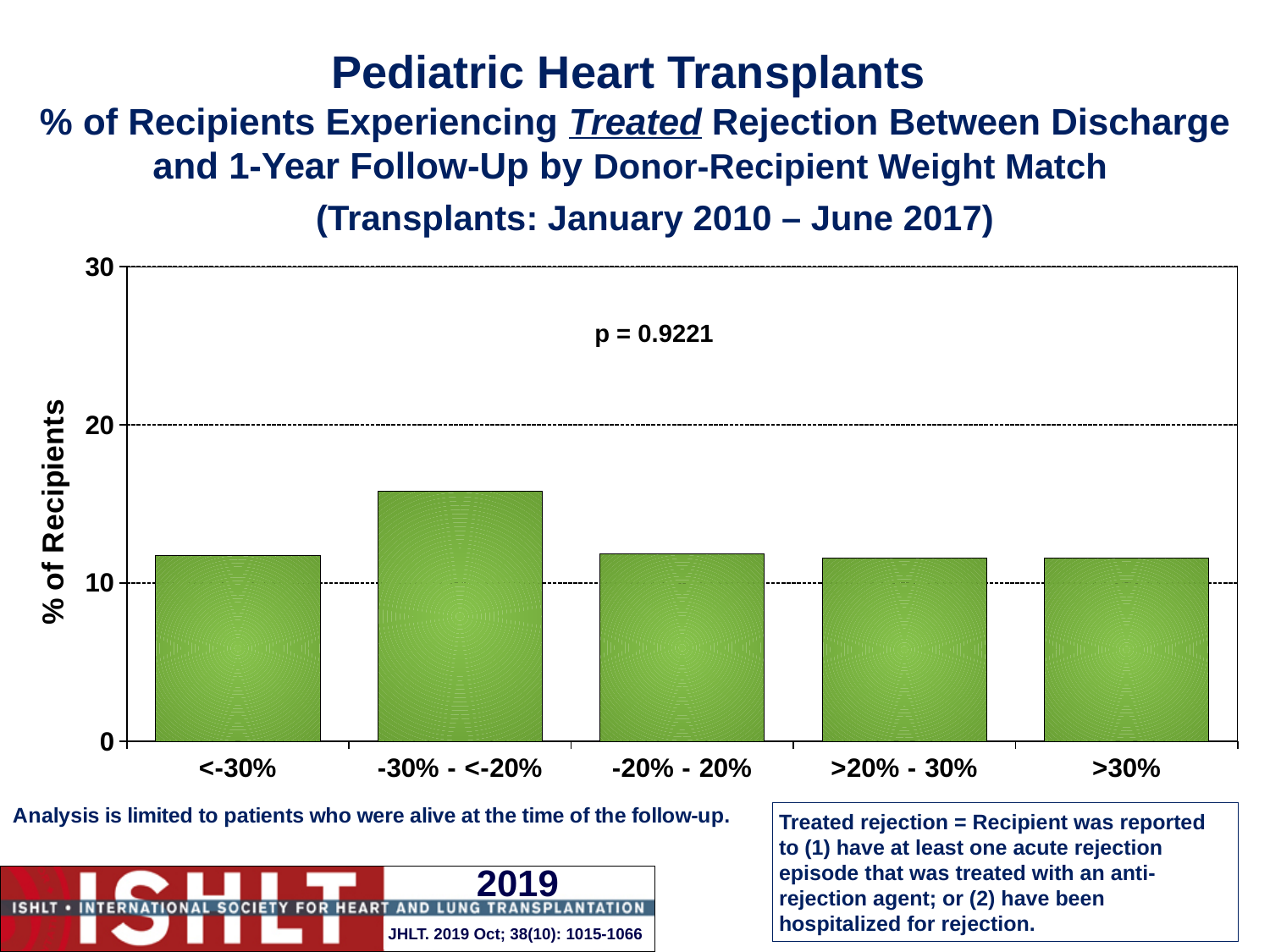
What is the maximum value shown on the y axis? 30 What kind of chart is shown on the slide? bar chart What p-value is printed on the chart? p = 0.9221 Which is larger, the value for -30% - <-20% or the value for >20% - 30%? -30% - <-20% Is the value for the >30% category greater or less than 20? less Which weight match category has the highest % of recipients experiencing treated rejection? -30% - <-20% How many donor-recipient weight match categories are shown on the x axis? 5 Is the value for the -20% - 20% category greater or less than 10? greater What is the label of the y axis? % of Recipients Is the value for the <-30% category greater or less than 10? greater Which is larger, the value for <-30% or the value for -30% - <-20%? -30% - <-20%